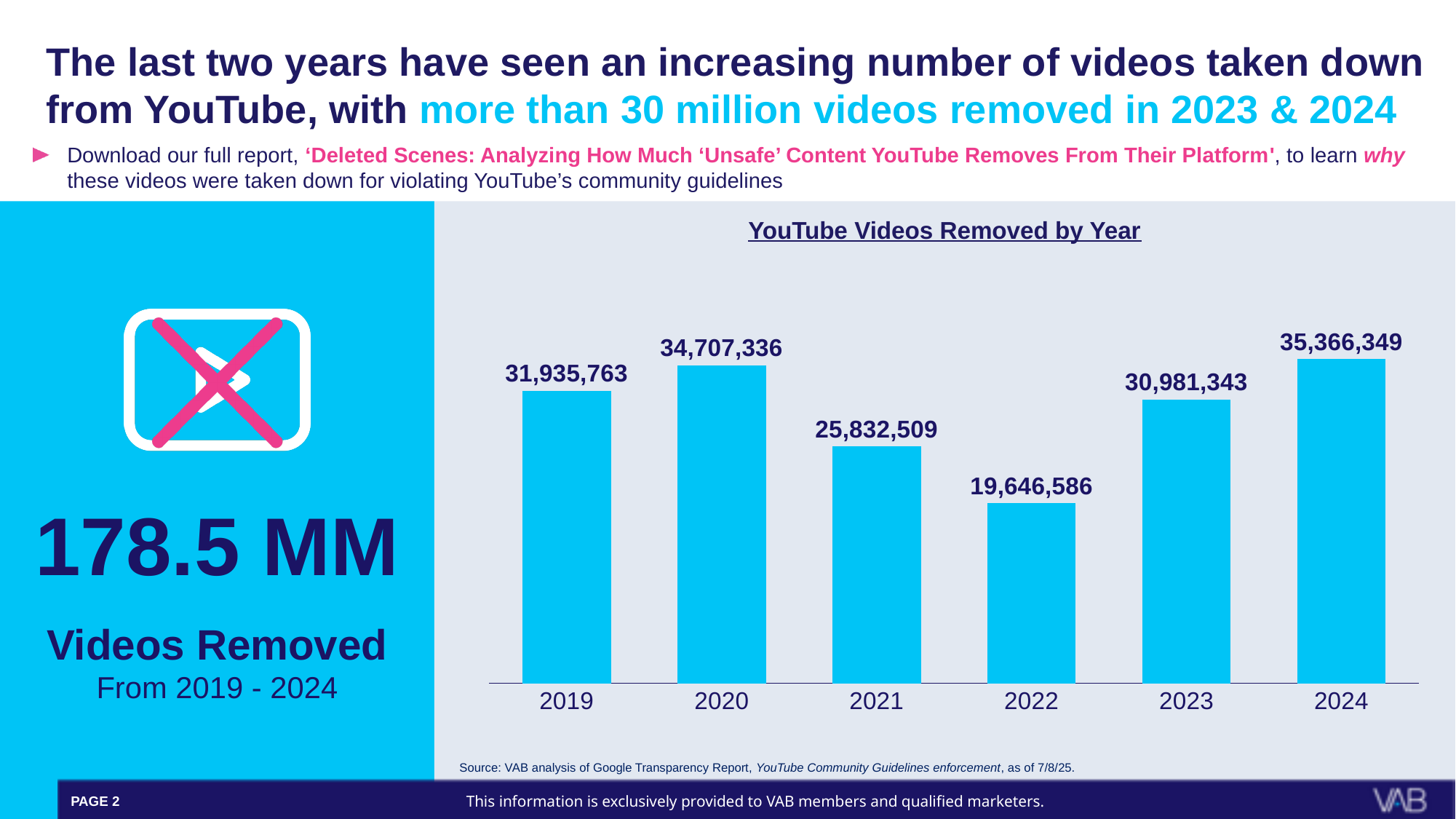
Which year has the highest number of videos removed? 2024 What is the value shown for 2024? 35,366,349 What is the title of the chart? YouTube Videos Removed by Year What is the difference between the values for 2024 and 2023? 4,385,006 Do the values rise or fall from 2022 to 2024? Rise Which year has a larger value, 2021 or 2023? 2023 What is the difference between the values for 2021 and 2022? 6,185,923 Which year has the lowest number of videos removed? 2022 How many years are shown on the x axis of the chart? 6 What is the value for 2019 in the YouTube Videos Removed by Year chart? 31,935,763 What kind of chart is used to show YouTube Videos Removed by Year? Bar chart How many videos were removed in 2022 according to the chart? 19,646,586